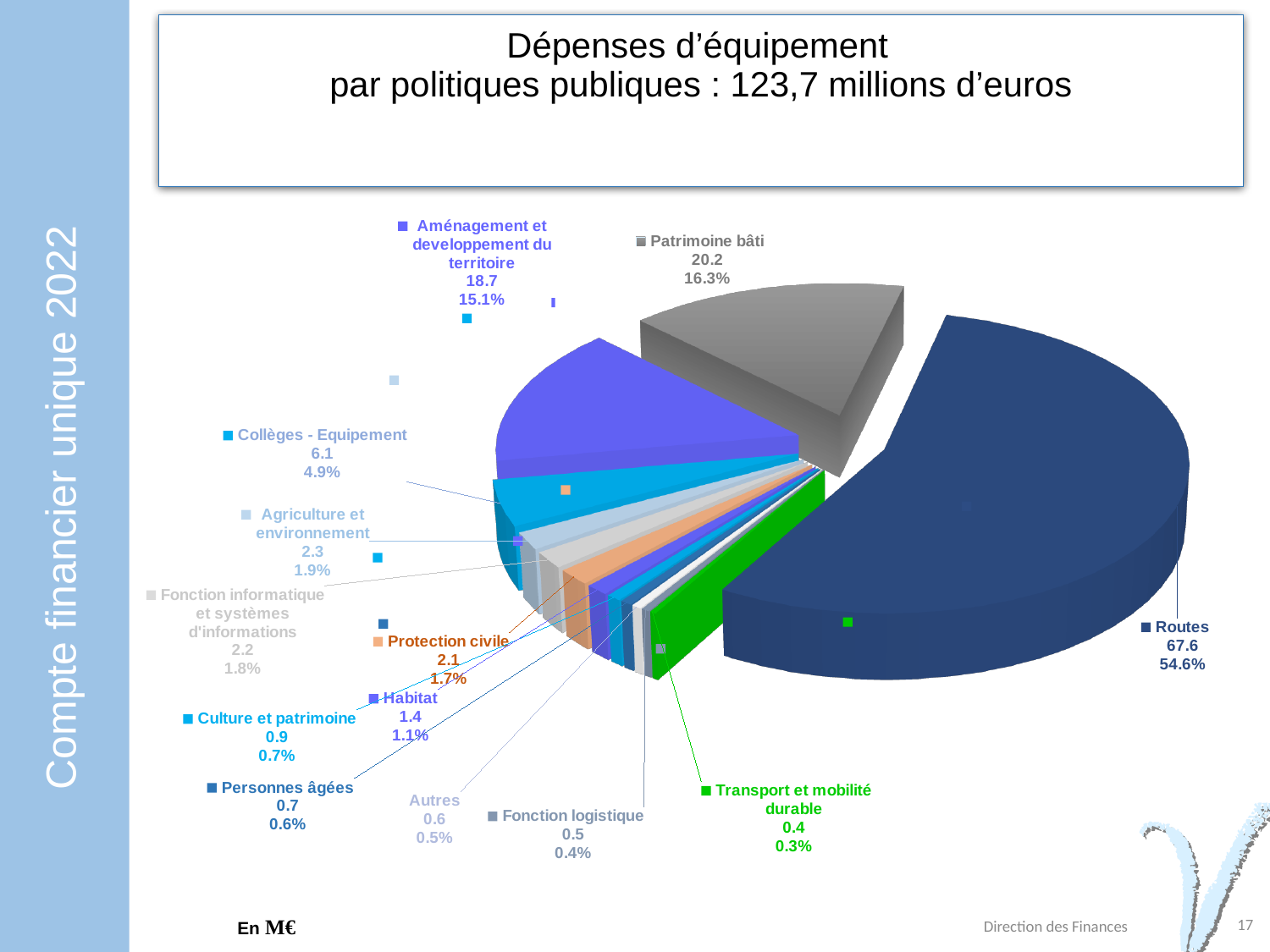
What type of chart is shown on the slide? Pie chart What total amount in millions of euros is stated in the chart title? 123,7 millions d'euros What share of the pie does Habitat represent? 1.1% What is the difference between the values for Patrimoine bâti and Aménagement et developpement du territoire? 1.5 What is the value for Routes? 67.6 What is the value for Protection civile? 2.1 How many categories are shown in the pie chart? 13 What is the value for Aménagement et developpement du territoire? 18.7 What share of the pie does Patrimoine bâti represent? 16.3% Which category has the smallest slice of the pie? Transport et mobilité durable Which is larger, the value for Collèges - Equipement or the value for Agriculture et environnement? Collèges - Equipement Which category has the largest slice of the pie? Routes